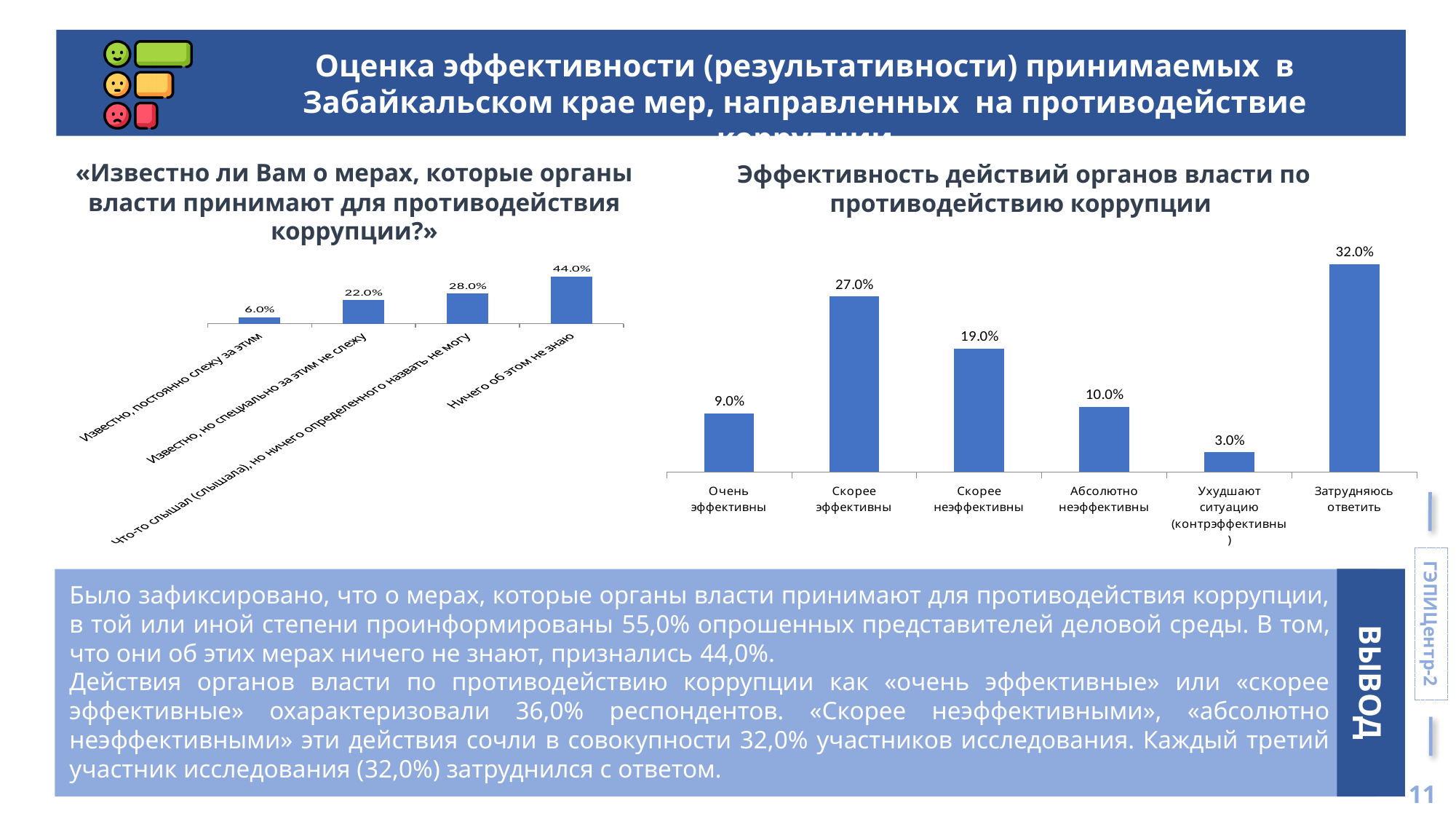
In the left chart («Известно ли Вам о мерах...»), what is the difference between «Что-то слышал (слышала), но ничего определенного назвать не могу» and «Известно, но специально за этим не слежу»? 6.0% In the right chart (Эффективность действий органов власти), what is the value for «Скорее эффективны»? 27.0% In the left chart («Известно ли Вам о мерах...»), what is the value for «Ничего об этом не знаю»? 44.0% In the right chart (Эффективность действий органов власти), what is the difference between «Затрудняюсь ответить» and «Очень эффективны»? 23.0% In the left chart («Известно ли Вам о мерах...»), what is the value for «Известно, постоянно слежу за этим»? 6.0% In the right chart (Эффективность действий органов власти), which category has the lowest value? Ухудшают ситуацию (контрэффективны) In the right chart (Эффективность действий органов власти), which category has the highest value? Затрудняюсь ответить In the right chart (Эффективность действий органов власти), what is the value for «Ухудшают ситуацию (контрэффективны)»? 3.0% What type of chart is the right chart (Эффективность действий органов власти)? Bar chart In the left chart («Известно ли Вам о мерах...»), which category has the highest value? Ничего об этом не знаю In the right chart (Эффективность действий органов власти), which is larger: «Скорее неэффективны» or «Абсолютно неэффективны»? Скорее неэффективны How many categories are shown in the left chart («Известно ли Вам о мерах...»)? 4